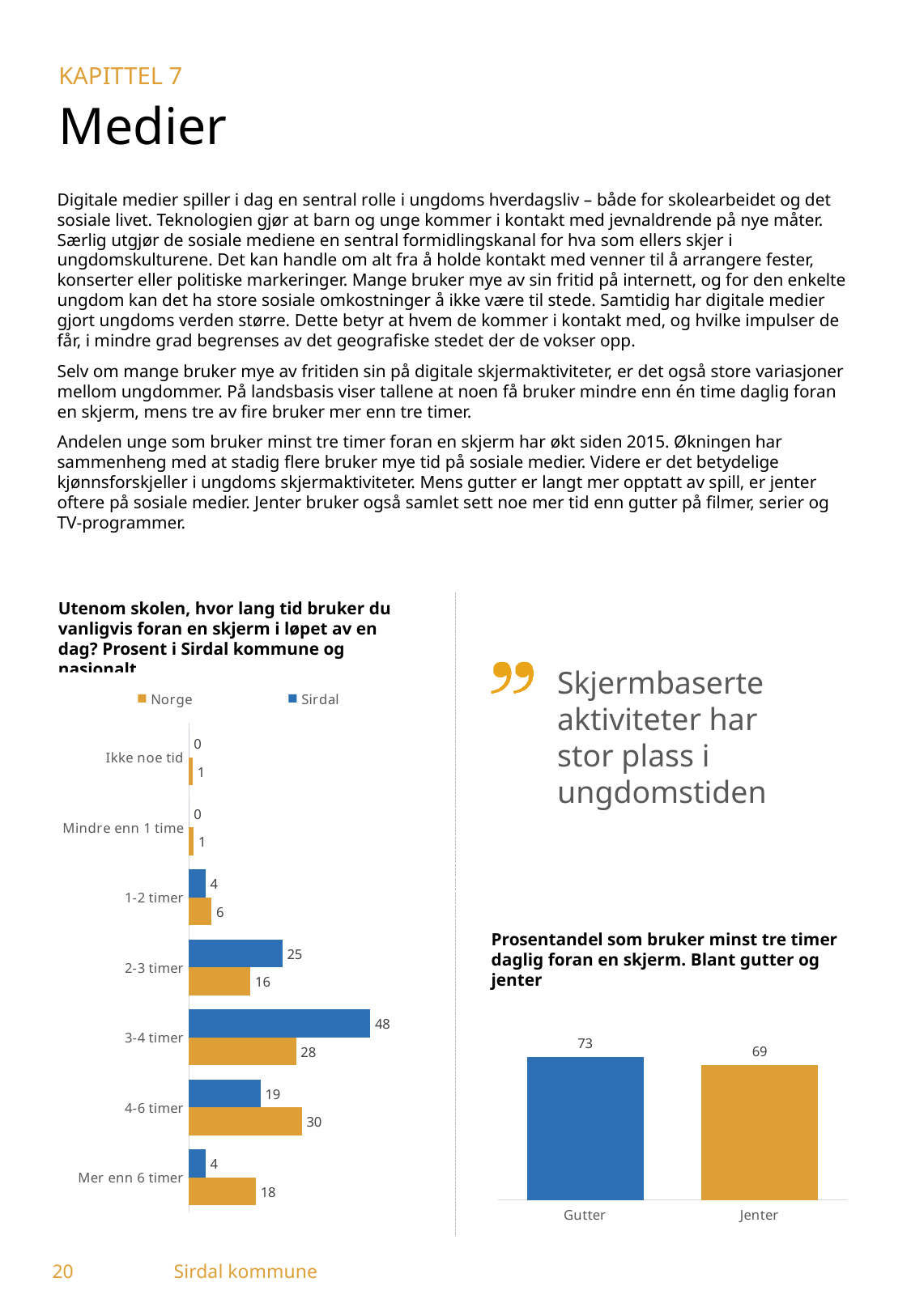
In the left chart (screen time per day), how many categories are shown? 7 In the right chart (share using at least three hours daily), what is the value for Gutter? 73 What kind of chart is the right chart (share using at least three hours daily)? Bar chart In the left chart (screen time per day), what is the value for Sirdal in the '3-4 timer' category? 48 In the left chart (screen time per day), what is the value for Norge in the '4-6 timer' category? 30 In the left chart (screen time per day), which category has the highest value for Norge? 4-6 timer In the left chart (screen time per day), which category has the highest value for Sirdal? 3-4 timer In the left chart (screen time per day), how many series does the legend list? 2 In the left chart (screen time per day), what is the difference between Sirdal and Norge in the '2-3 timer' category? 9 In the left chart (screen time per day), what is the value for Norge in the 'Mer enn 6 timer' category? 18 In the right chart (share using at least three hours daily), what is the difference between Gutter and Jenter? 4 In the left chart (screen time per day), which is larger in the 'Mer enn 6 timer' category, Sirdal or Norge? Norge